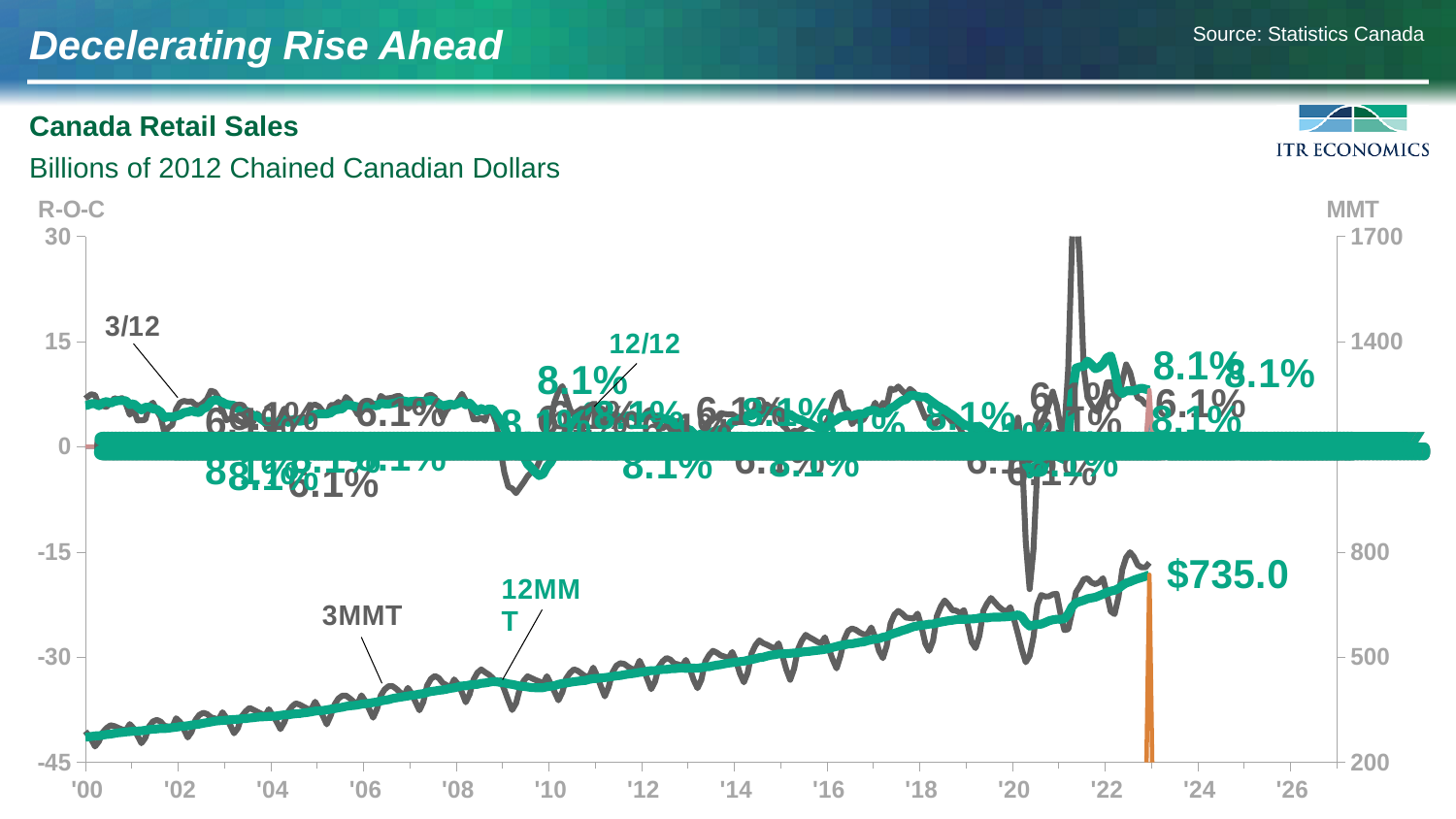
What units does the chart subtitle say the data is in? Billions of 2012 Chained Canadian Dollars Is the 12MMT value in '22 greater or less than 500 on the MMT axis? greater Which is larger, the 12MMT value in '20 or the 12MMT value in '10? '20 Is the 12MMT value in '00 greater or less than 500 on the MMT axis? less How many series are labeled on the chart (3/12, 12/12, 3MMT, 12MMT)? 4 Is the 12MMT value in '04 greater or less than 500 on the MMT axis? less Which is larger, the 12MMT value in '16 or the 12MMT value in '02? '16 What is the latest 12MMT value labeled on the chart? $735.0 Does the 12MMT line rise or fall from '00 to '22? rise What kind of chart is shown on the slide? line chart What is the title of the chart? Canada Retail Sales